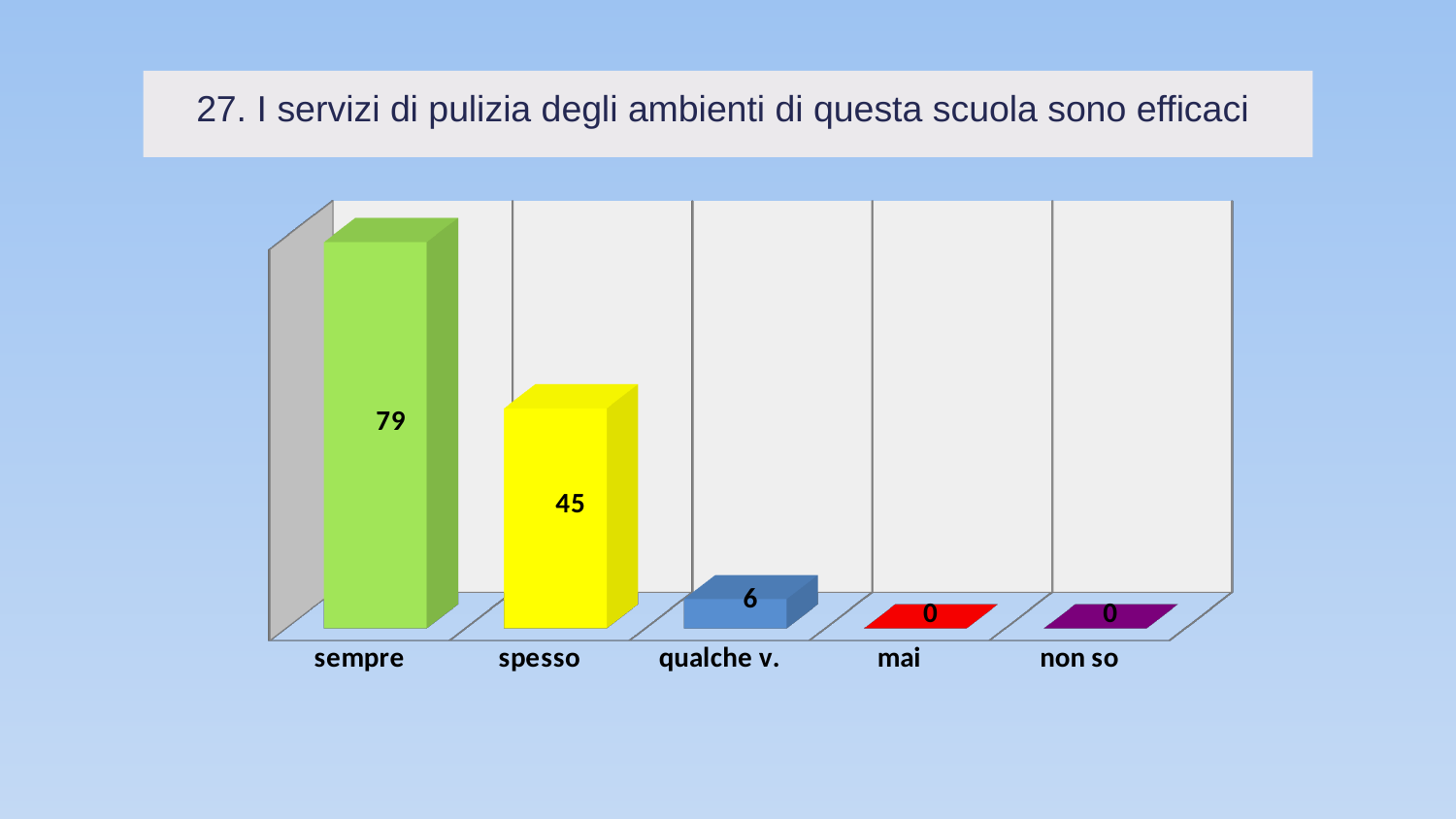
What is the value for "sempre"? 79 What is the title of the slide above the chart? 27. I servizi di pulizia degli ambienti di questa scuola sono efficaci Do the values rise or fall from left to right along the x axis? fall What is the difference between the values for "sempre" and "spesso"? 34 What is the difference between the values for "spesso" and "qualche v."? 39 What is the value for "qualche v."? 6 How many categories are shown on the x axis? 5 What is the value for "mai"? 0 Which is larger, the value for "spesso" or the value for "qualche v."? spesso What is the value for "spesso"? 45 What kind of chart is shown on the slide? bar chart Which category has the highest value? sempre